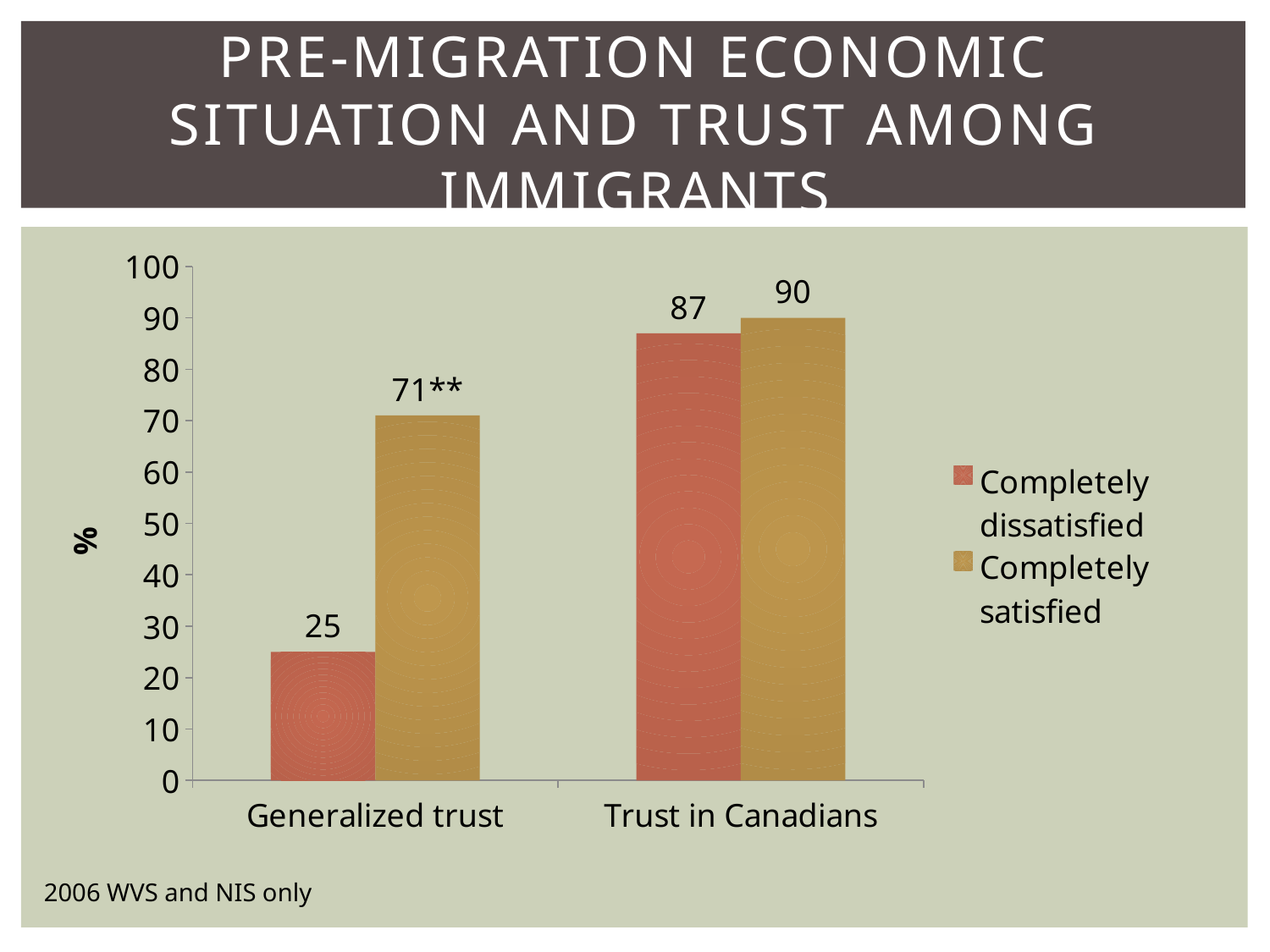
How many series does the legend list? 2 Which bar has the highest value on the chart? Completely satisfied, Trust in Canadians What is the label on the vertical axis? % Which is larger for Generalized trust: Completely dissatisfied or Completely satisfied? Completely satisfied What is the data label shown for Completely satisfied under Generalized trust? 71** What is the difference between the Completely satisfied and Completely dissatisfied values for Trust in Canadians? 3 What kind of chart is shown on the slide? Bar chart What is the difference between the Completely satisfied and Completely dissatisfied values for Generalized trust? 46 What is the value for Completely dissatisfied under Generalized trust? 25 What is the value for Completely dissatisfied under Trust in Canadians? 87 What is the value for Completely satisfied under Trust in Canadians? 90 Which bar has the lowest value on the chart? Completely dissatisfied, Generalized trust